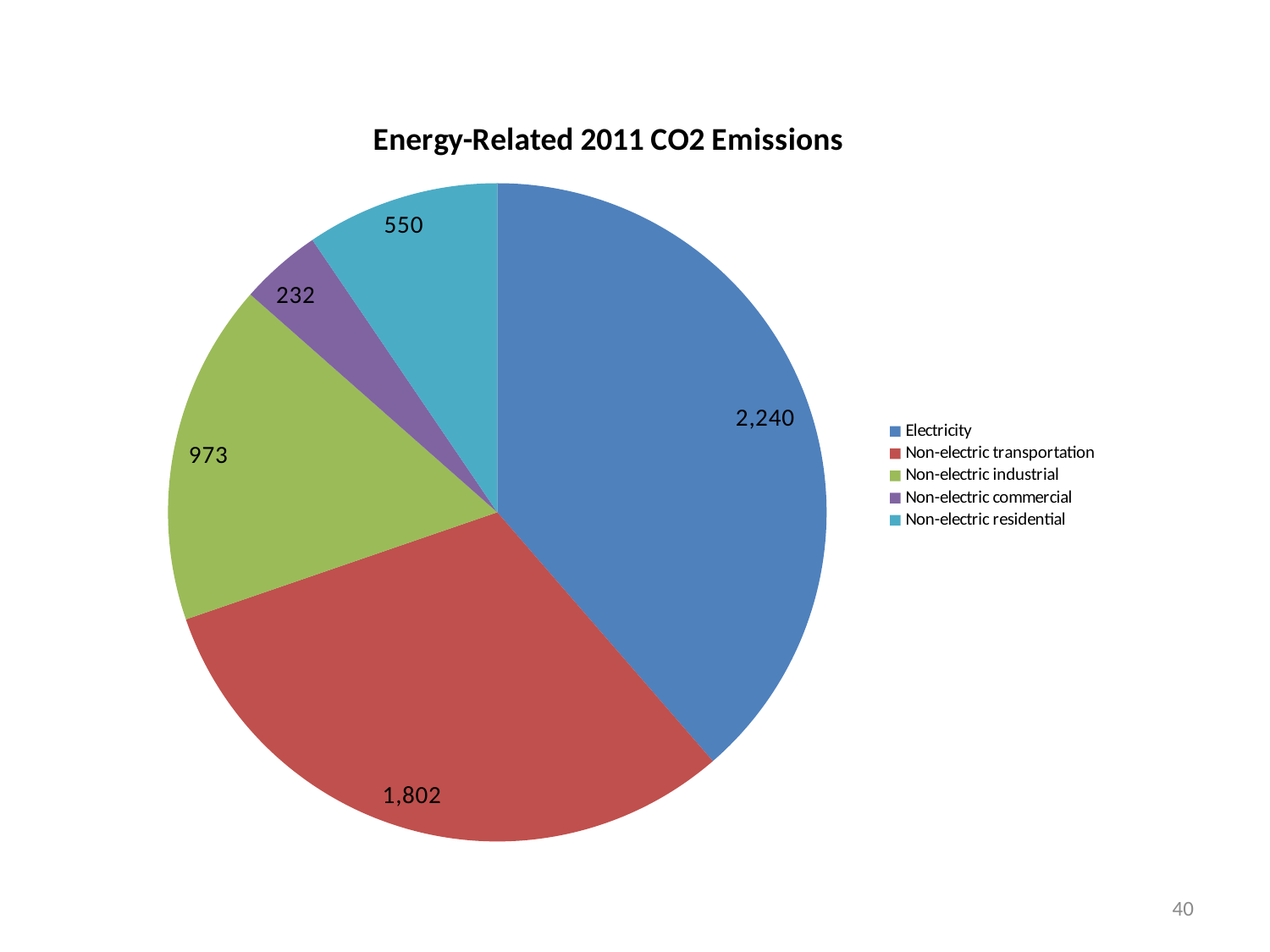
What is the value for Non-electric commercial? 232 What kind of chart is shown on the slide? Pie chart What is the value for Non-electric transportation? 1,802 What is the title of the chart? Energy-Related 2011 CO2 Emissions What is the value for Electricity? 2,240 What is the value for Non-electric industrial? 973 What is the value for Non-electric residential? 550 Which category has the smallest slice? Non-electric commercial How many categories does the pie chart show? 5 What is the difference between the Electricity value and the Non-electric transportation value? 438 Which is larger, Non-electric industrial or Non-electric residential? Non-electric industrial Which category has the largest slice? Electricity